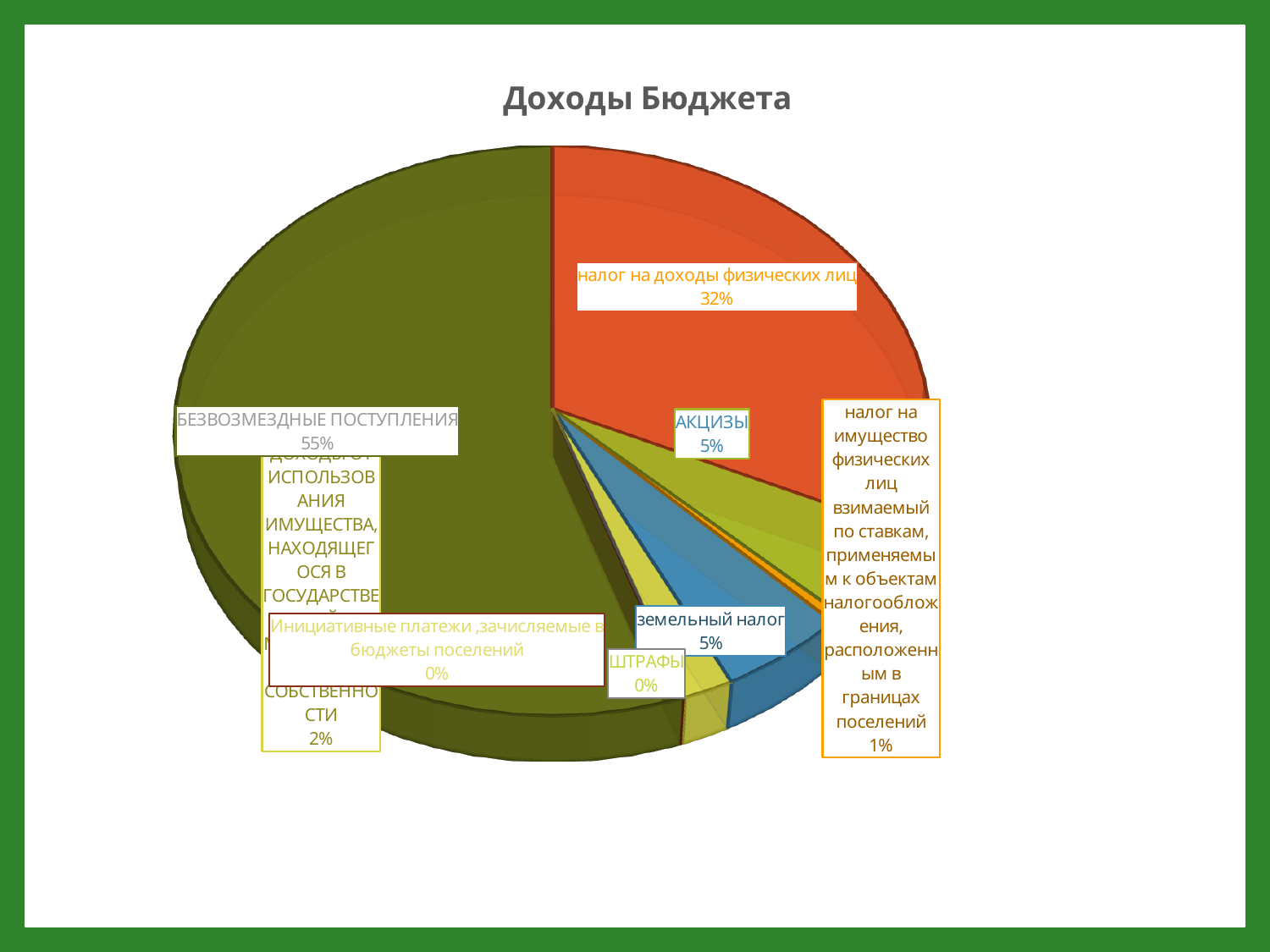
What percentage is shown for Инициативные платежи, зачисляемые в бюджеты поселений? 0% Which category has the largest share of the pie? БЕЗВОЗМЕЗДНЫЕ ПОСТУПЛЕНИЯ What share of the pie is БЕЗВОЗМЕЗДНЫЕ ПОСТУПЛЕНИЯ? 55% What share of the pie is налог на доходы физических лиц? 32% What percentage is shown for земельный налог? 5% Which is larger: the share for налог на доходы физических лиц or the share for АКЦИЗЫ? налог на доходы физических лиц What percentage is shown for АКЦИЗЫ? 5% What percentage is shown for налог на имущество физических лиц? 1% What percentage is shown for ШТРАФЫ? 0% What is the difference in percentage points between БЕЗВОЗМЕЗДНЫЕ ПОСТУПЛЕНИЯ and налог на доходы физических лиц? 23 percentage points What is the title of the chart? Доходы Бюджета What type of chart is shown on the slide? pie chart